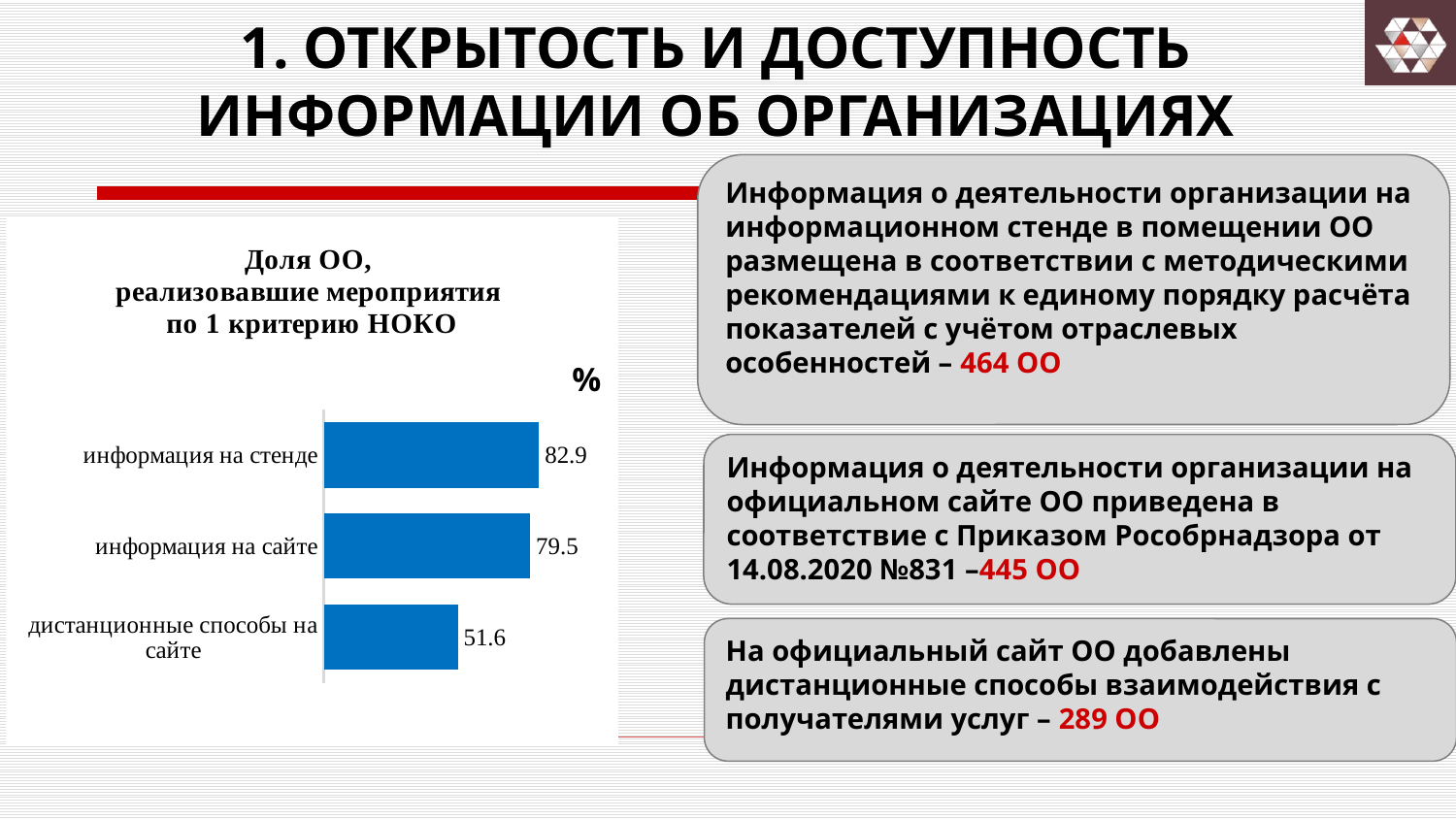
Which category has the highest value? информация на стенде Which category has the lowest value? дистанционные способы на сайте What is the difference between the values for "информация на стенде" and "информация на сайте"? 3.4 What is the value for "информация на стенде"? 82.9 What unit is indicated above the bars in the chart? % How many categories are shown in the chart? 3 What is the value for "дистанционные способы на сайте"? 51.6 What is the title of the chart? Доля ОО, реализовавшие мероприятия по 1 критерию НОКО What kind of chart is shown on the slide? bar chart What is the difference between the values for "информация на сайте" and "дистанционные способы на сайте"? 27.9 Which is larger: the value for "информация на сайте" or for "дистанционные способы на сайте"? информация на сайте What is the value for "информация на сайте"? 79.5